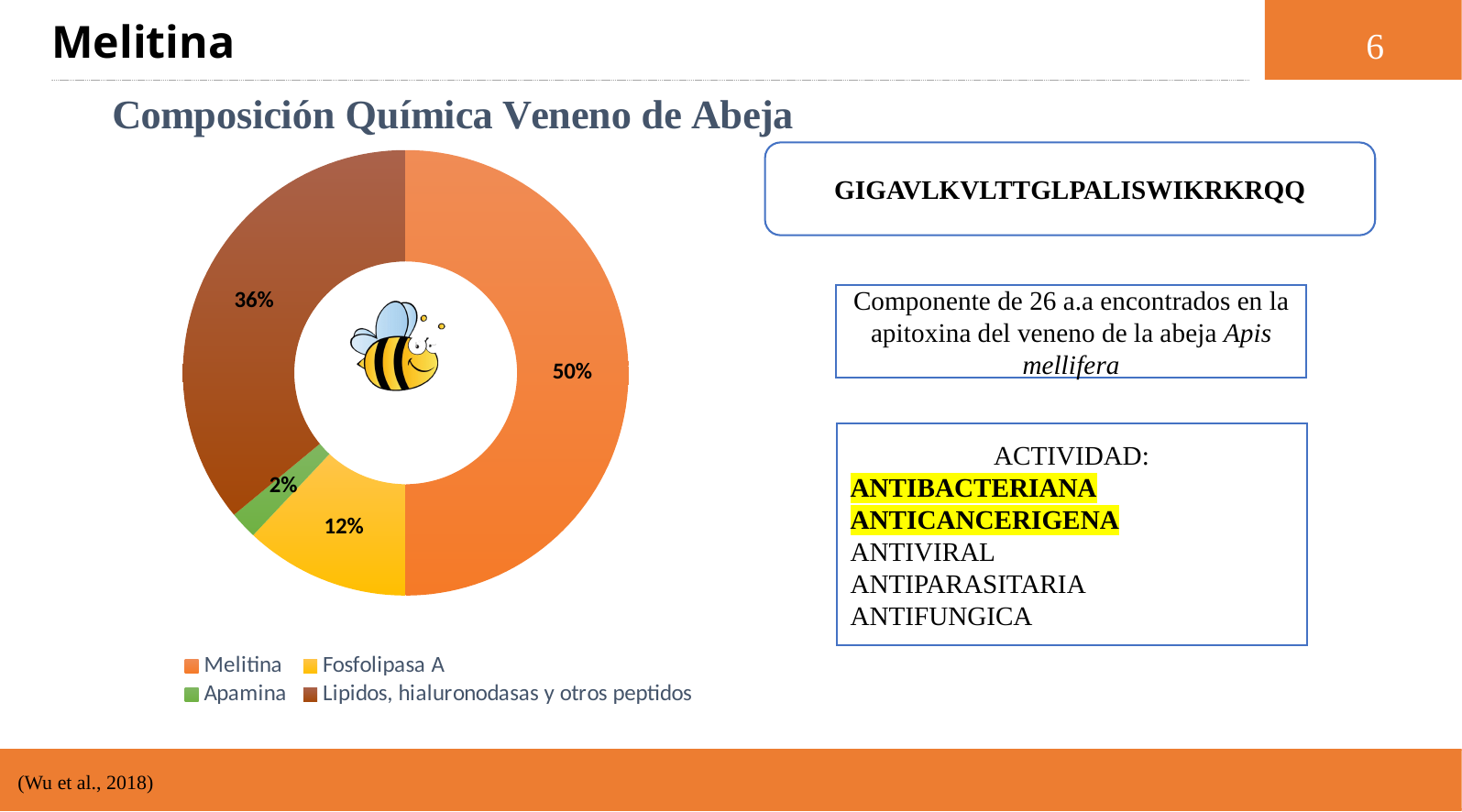
What is the difference in percentage points between Melitina and Fosfolipasa A? 38 What is the title of the chart? Composición Química Veneno de Abeja What percentage of the bee venom composition is Apamina? 2% What percentage of the bee venom composition is Fosfolipasa A? 12% How many components are shown in the chart? 4 What percentage of the bee venom composition is Melitina? 50% Which component has the largest share of the bee venom composition? Melitina What kind of chart is used to show the bee venom composition? Pie chart (doughnut) What colour represents Apamina in the chart? Green Which has a larger share, Fosfolipasa A or Apamina? Fosfolipasa A What percentage of the bee venom composition is 'Lipidos, hialuronodasas y otros peptidos'? 36% Which component has the smallest share of the bee venom composition? Apamina